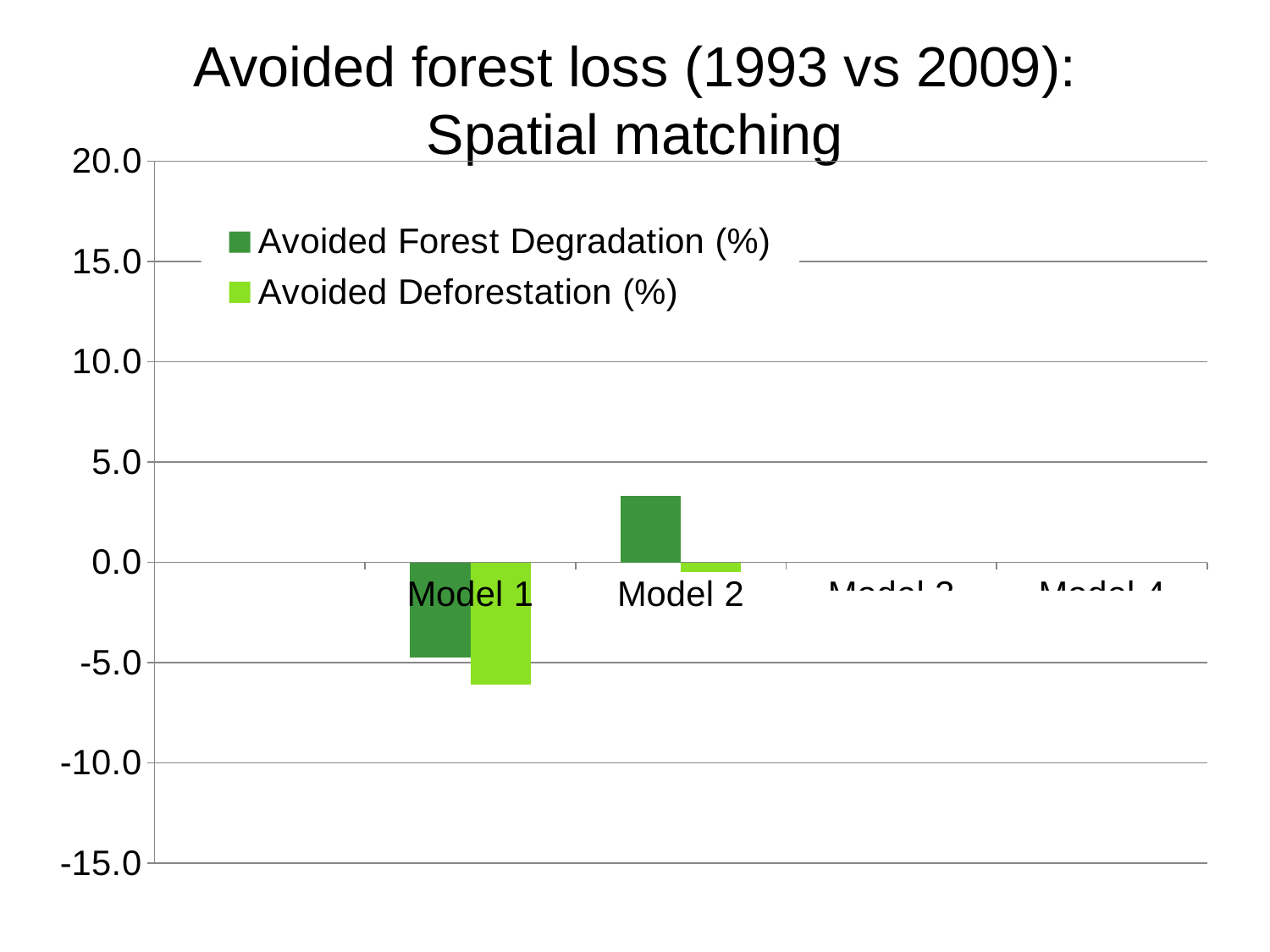
Does the Avoided Forest Degradation (%) value rise or fall from Model 1 to Model 2? rise Is the Avoided Forest Degradation (%) value for Model 1 greater or less than 0.0? less Is the Avoided Forest Degradation (%) value for Model 2 greater or less than 0.0? greater Which series is shown in the lighter green colour? Avoided Deforestation (%) What type of chart is shown on the slide? Bar chart Is the Avoided Deforestation (%) value for Model 1 greater or less than -5.0? less For Model 1, which series has the larger value: Avoided Forest Degradation (%) or Avoided Deforestation (%)? Avoided Forest Degradation (%) What is the title of the chart? Avoided forest loss (1993 vs 2009): Spatial matching How many series does the legend list? 2